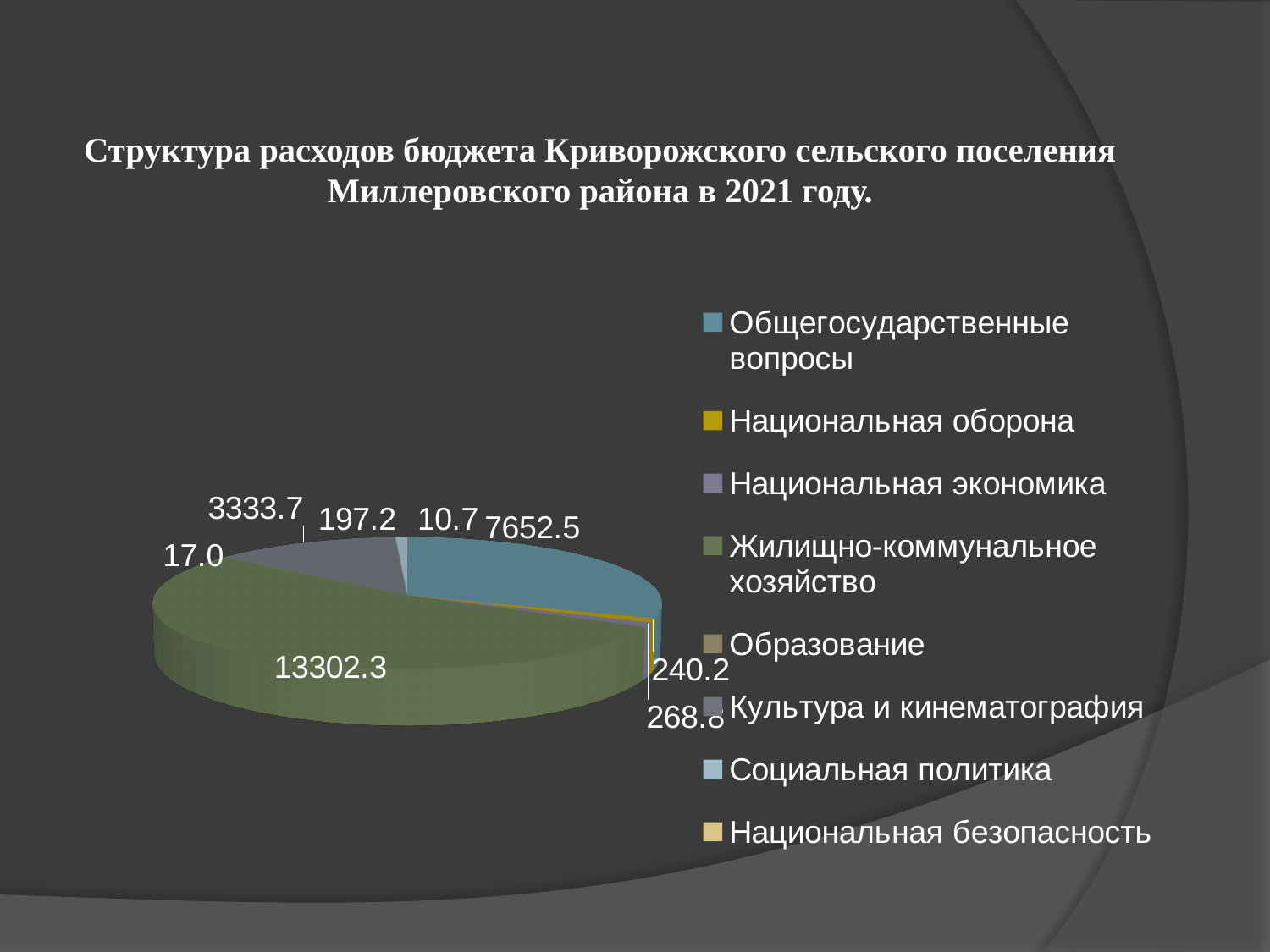
What is the value shown for Общегосударственные вопросы? 7652.5 What is the value shown for Культура и кинематография? 3333.7 What is the value shown for Жилищно-коммунальное хозяйство? 13302.3 What kind of chart is shown on the slide? Pie chart Which is larger: the value for Общегосударственные вопросы or the value for Культура и кинематография? Общегосударственные вопросы What is the difference between the values for Жилищно-коммунальное хозяйство and Общегосударственные вопросы? 5649.8 What colour is the slice for Жилищно-коммунальное хозяйство? Green Which category has the largest slice of the pie? Жилищно-коммунальное хозяйство What year does the chart title say the budget expenditure structure refers to? 2021 How many categories does the legend of the pie chart list? 8 What is the largest value labelled on the pie chart? 13302.3 What is the smallest value labelled on the pie chart? 10.7